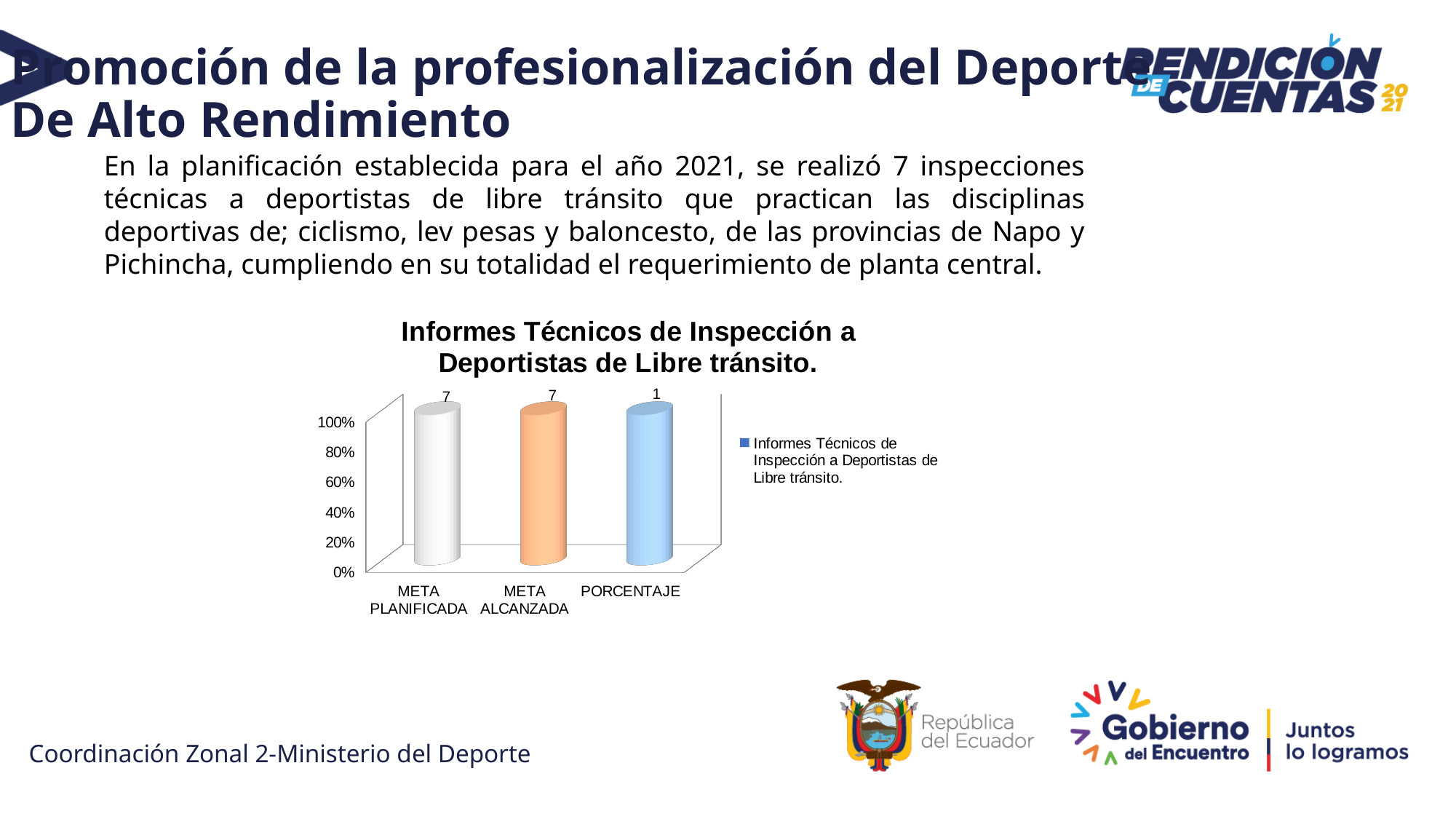
What is the data label shown for PORCENTAJE? 1 What is the title of the chart? Informes Técnicos de Inspección a Deportistas de Libre tránsito. Which category has the smallest data label? PORCENTAJE How many series does the chart legend list? 1 What kind of chart is shown on the slide? Bar chart What is the data label shown for META PLANIFICADA? 7 Is the bar for PORCENTAJE greater or less than 60% on the axis? greater Is the bar for META ALCANZADA greater or less than 80% on the axis? greater How many categories are shown on the x axis of the chart? 3 What is the highest percentage tick shown on the vertical axis? 100% What is the data label shown for META ALCANZADA? 7 What is the difference between the data labels for META PLANIFICADA and META ALCANZADA? 0